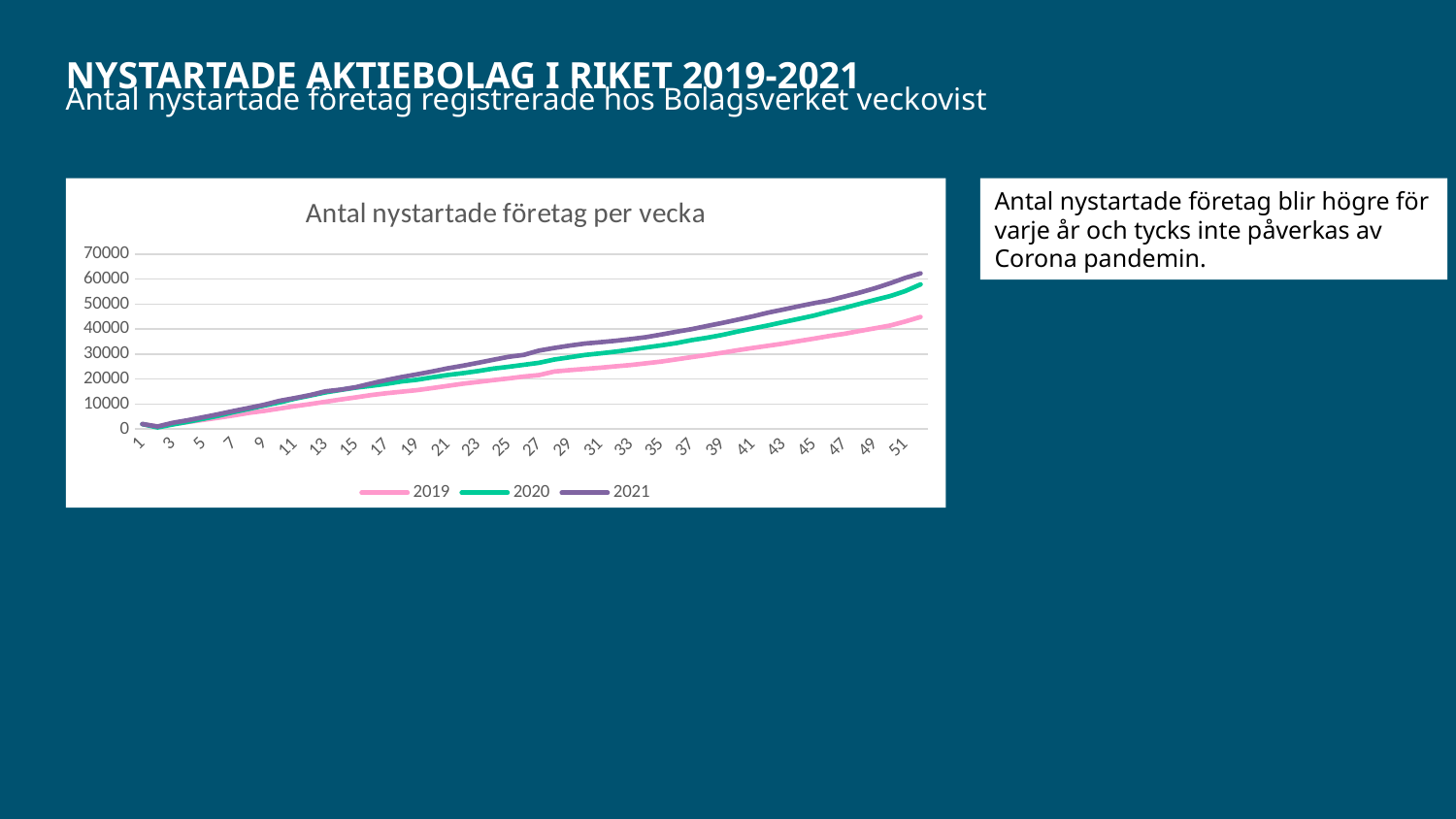
Is the value for 2020 at week 51 greater or less than 60000? less Which series has the highest value at week 51? 2021 Do the values for 2021 rise or fall as the week number increases? rise Is the value for 2021 at week 13 greater or less than 10000? greater How many series does the legend list? 3 Which years are listed in the chart legend? 2019, 2020, 2021 Which series has the lowest value at week 51? 2019 What is the title of the chart? Antal nystartade företag per vecka Is the value for 2019 at week 51 greater or less than 40000? greater What kind of chart is shown on the slide? line chart At week 51, which is larger: the value for 2019 or the value for 2021? 2021